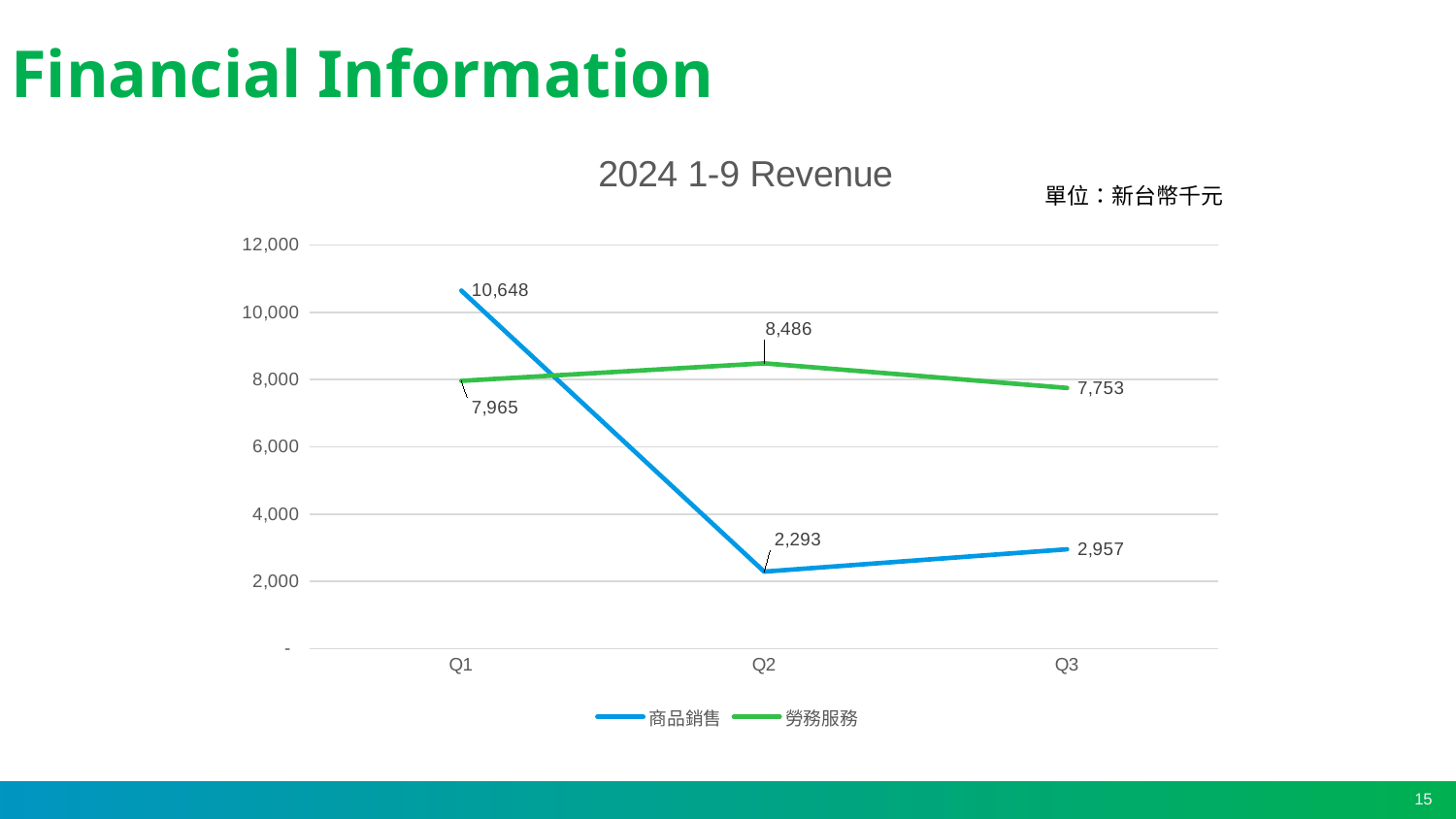
How many series does the legend list? 2 In which quarter is 勞務服務 highest? Q2 In which quarter is 商品銷售 lowest? Q2 What is the value for 商品銷售 in Q3? 2,957 Which is larger in Q3, 商品銷售 or 勞務服務? 勞務服務 What is the value for 勞務服務 in Q3? 7,753 What is the title of the chart? 2024 1-9 Revenue What is the value for 商品銷售 in Q1? 10,648 What is the value for 勞務服務 in Q2? 8,486 What kind of chart is shown? Line chart What is the difference between 商品銷售 and 勞務服務 in Q1? 2,683 How many quarters are shown on the x axis? 3